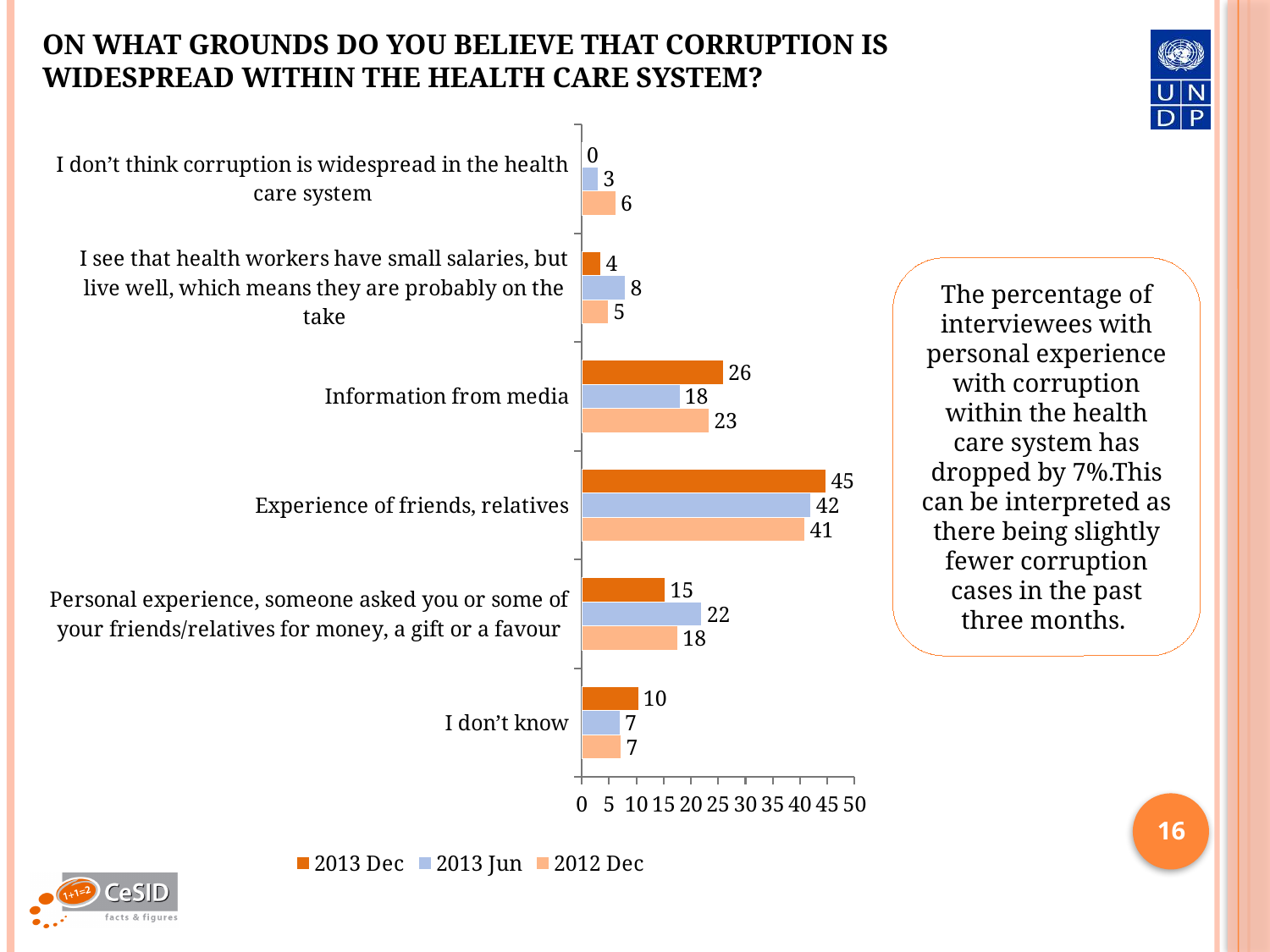
What is the 2013 Dec value for "Personal experience, someone asked you or some of your friends/relatives for money, a gift or a favour"? 15 How many categories are shown on the chart? 6 What kind of chart is shown on the slide? Bar chart What is the 2012 Dec value for "I don't know"? 7 Which category has the lowest 2013 Dec value? I don't think corruption is widespread in the health care system For "Information from media", which is larger: the 2013 Dec value or the 2012 Dec value? 2013 Dec Which series is shown in dark orange in the legend? 2013 Dec How many series does the legend list? 3 What is the 2013 Dec value for "Experience of friends, relatives"? 45 What is the difference between the 2013 Jun and 2013 Dec values for "Personal experience, someone asked you or some of your friends/relatives for money, a gift or a favour"? 7 What is the 2013 Jun value for "Information from media"? 18 Which category has the highest 2013 Dec value? Experience of friends, relatives